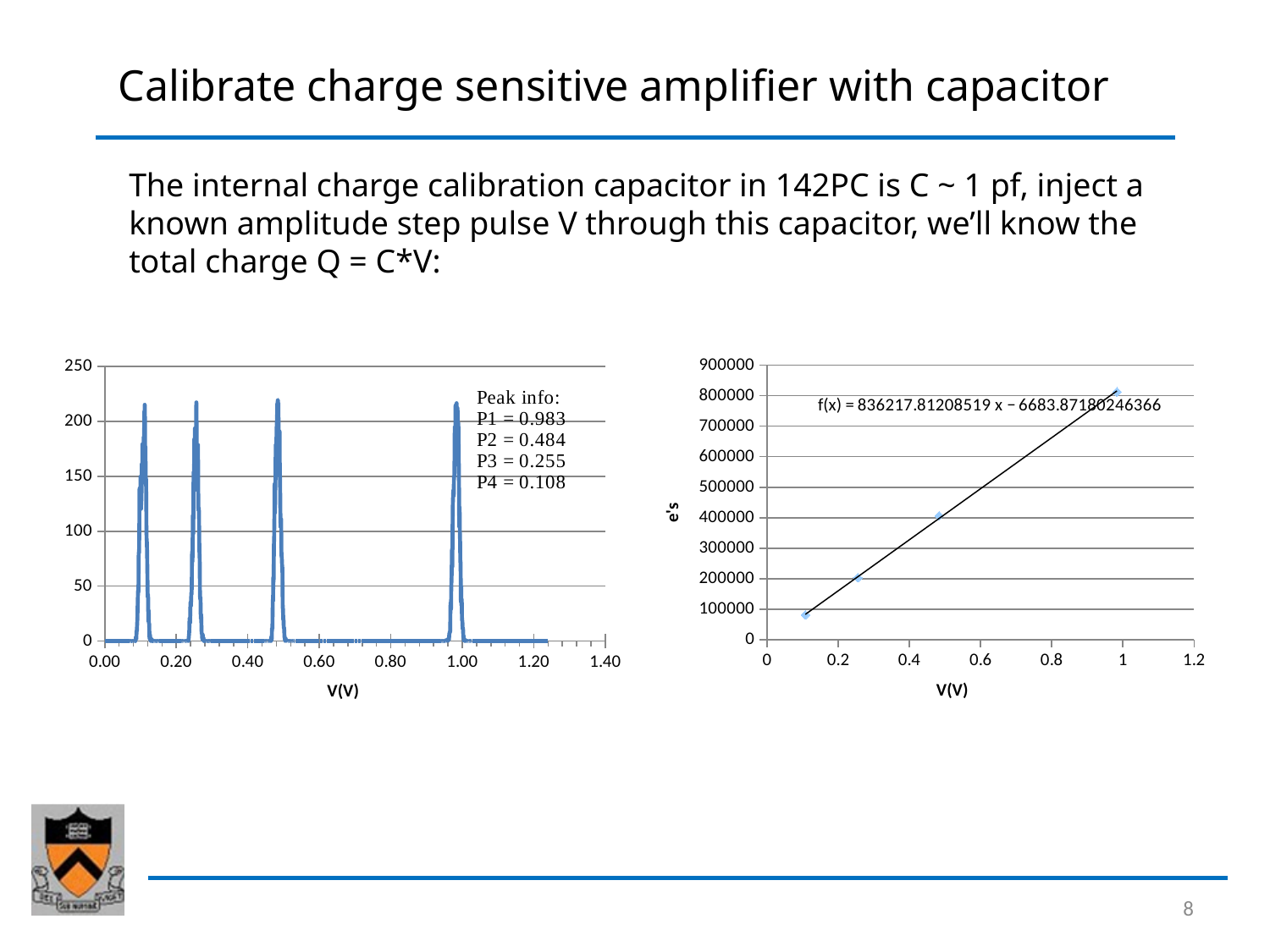
In the right chart, do the e's values rise or fall as V(V) increases? rise How many data points are plotted in the right chart? 4 How many peaks are shown in the left chart? 4 What kind of chart is the right chart on the slide? scatter chart In the left chart's peak info box, what is the value of P1? 0.983 What is the trendline equation shown on the right chart? f(x) = 836217.81208519 x − 6683.87180246366 In the right chart, is the e's value for the point near V = 0.5 greater or less than 300000? greater In the left chart, is the height of the peak near V = 1.00 greater or less than 200? greater In the left chart's peak info box, what is the value of P4? 0.108 In the right chart, is the e's value for the point near V = 1 greater or less than 700000? greater What kind of chart is the left chart on the slide? line chart